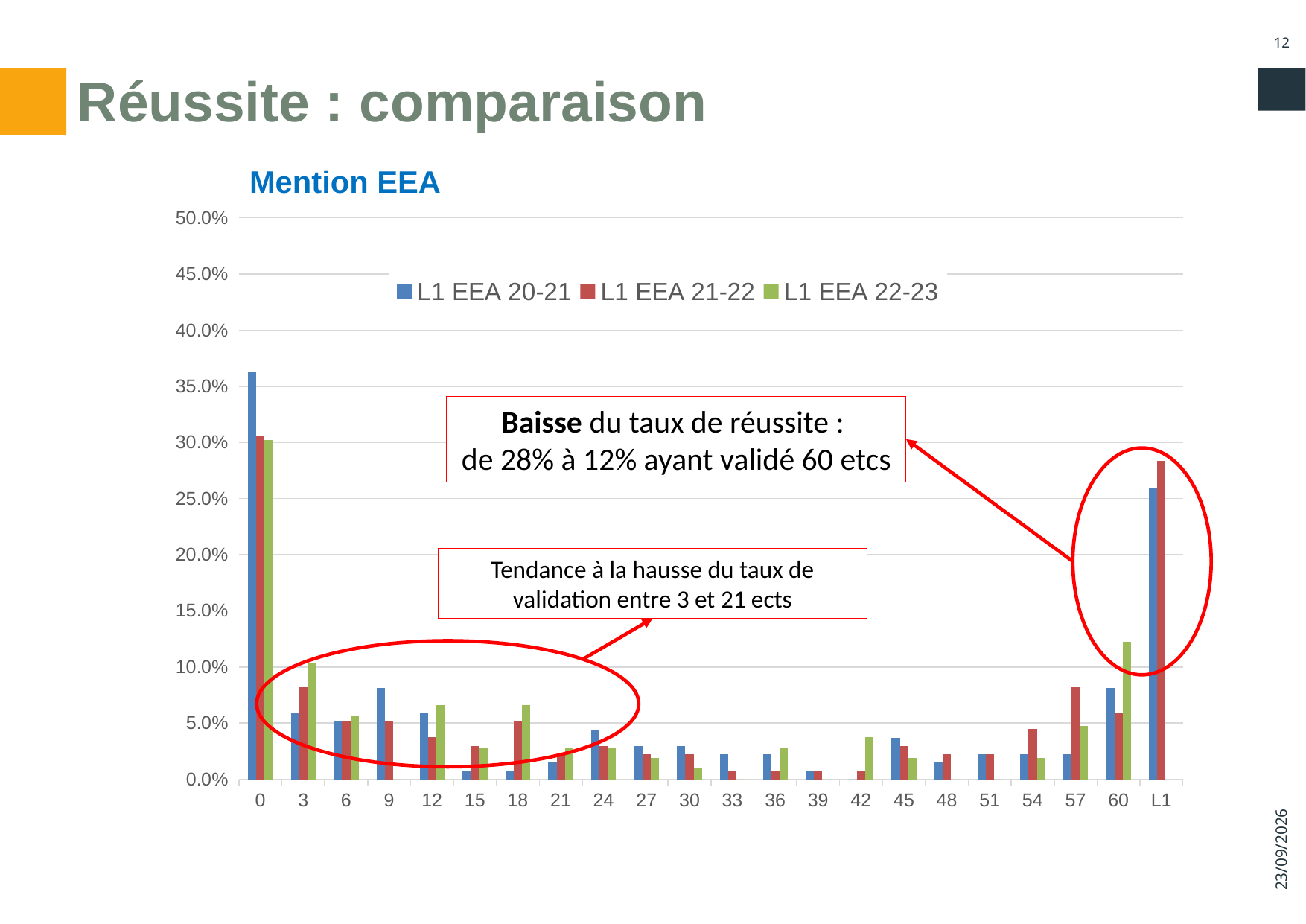
Is the value for L1 EEA 22-23 at category 60 greater or less than 10.0%? greater What is the title of the chart? Mention EEA For the series L1 EEA 20-21, which category has the highest value? 0 How many series does the legend list? 3 Is the value for L1 EEA 21-22 at category L1 greater or less than 25.0%? greater At category 57, which series has the larger value: L1 EEA 20-21 or L1 EEA 21-22? L1 EEA 21-22 At category 60, which series has the larger value: L1 EEA 20-21 or L1 EEA 22-23? L1 EEA 22-23 How many categories are shown on the x axis? 22 What type of chart is shown on the slide? Bar chart Which series is shown in green in the legend? L1 EEA 22-23 Is the value for L1 EEA 20-21 at category 0 greater or less than 30.0%? greater